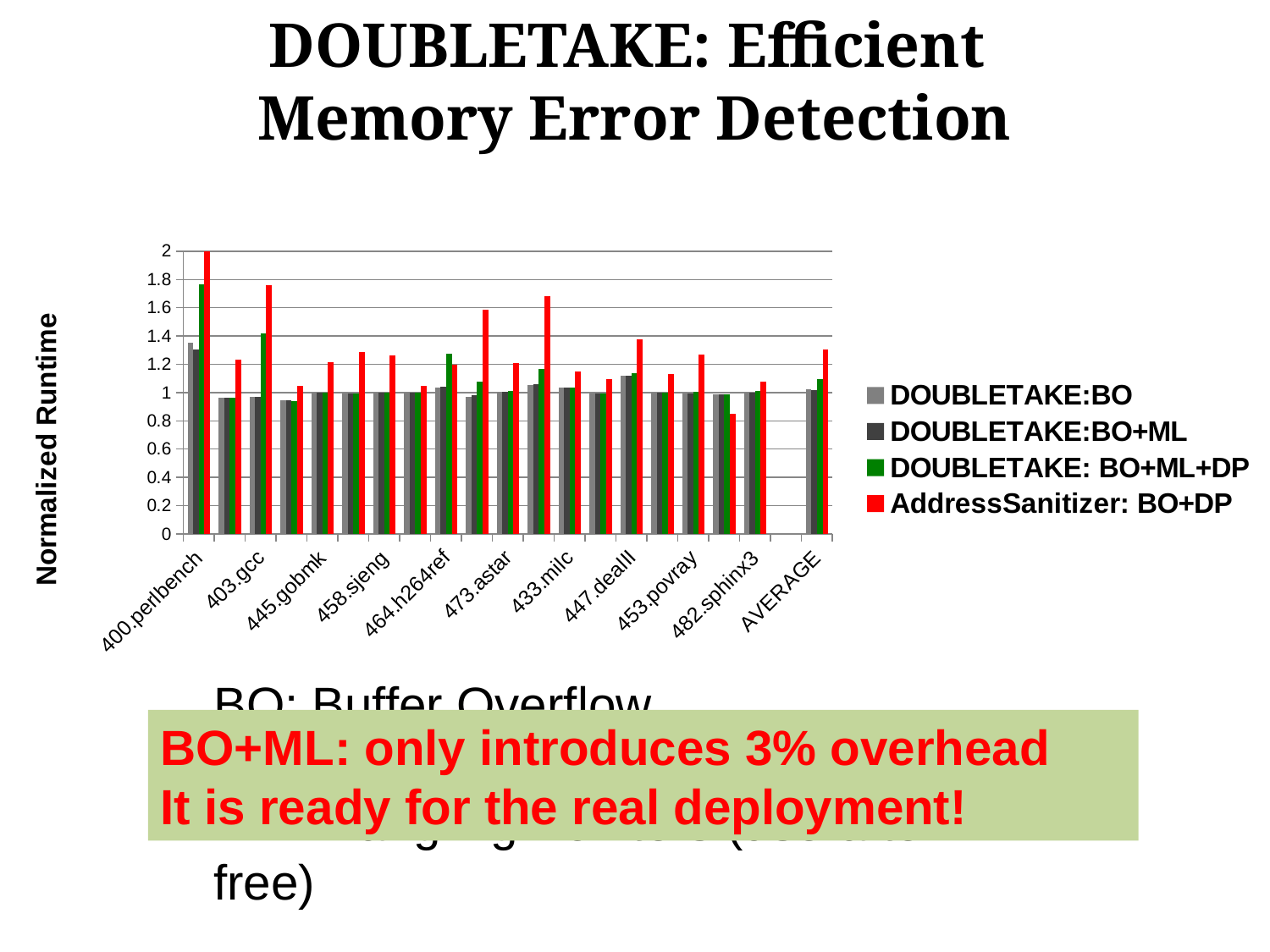
Which colour represents the AddressSanitizer: BO+DP series in the chart? red How many series does the chart's legend list? 4 What kind of chart is shown on the slide? bar chart For 403.gcc, which is larger: the AddressSanitizer: BO+DP value or the DOUBLETAKE: BO+ML+DP value? AddressSanitizer: BO+DP Which category has the highest AddressSanitizer: BO+DP value? 400.perlbench Is the AddressSanitizer: BO+DP value for 482.sphinx3 greater or less than 1? greater What is the title of the chart's y axis? Normalized Runtime Is the AddressSanitizer: BO+DP value for 400.perlbench greater or less than 1.8? greater Is the DOUBLETAKE: BO+ML+DP value for 400.perlbench greater or less than 1.6? greater